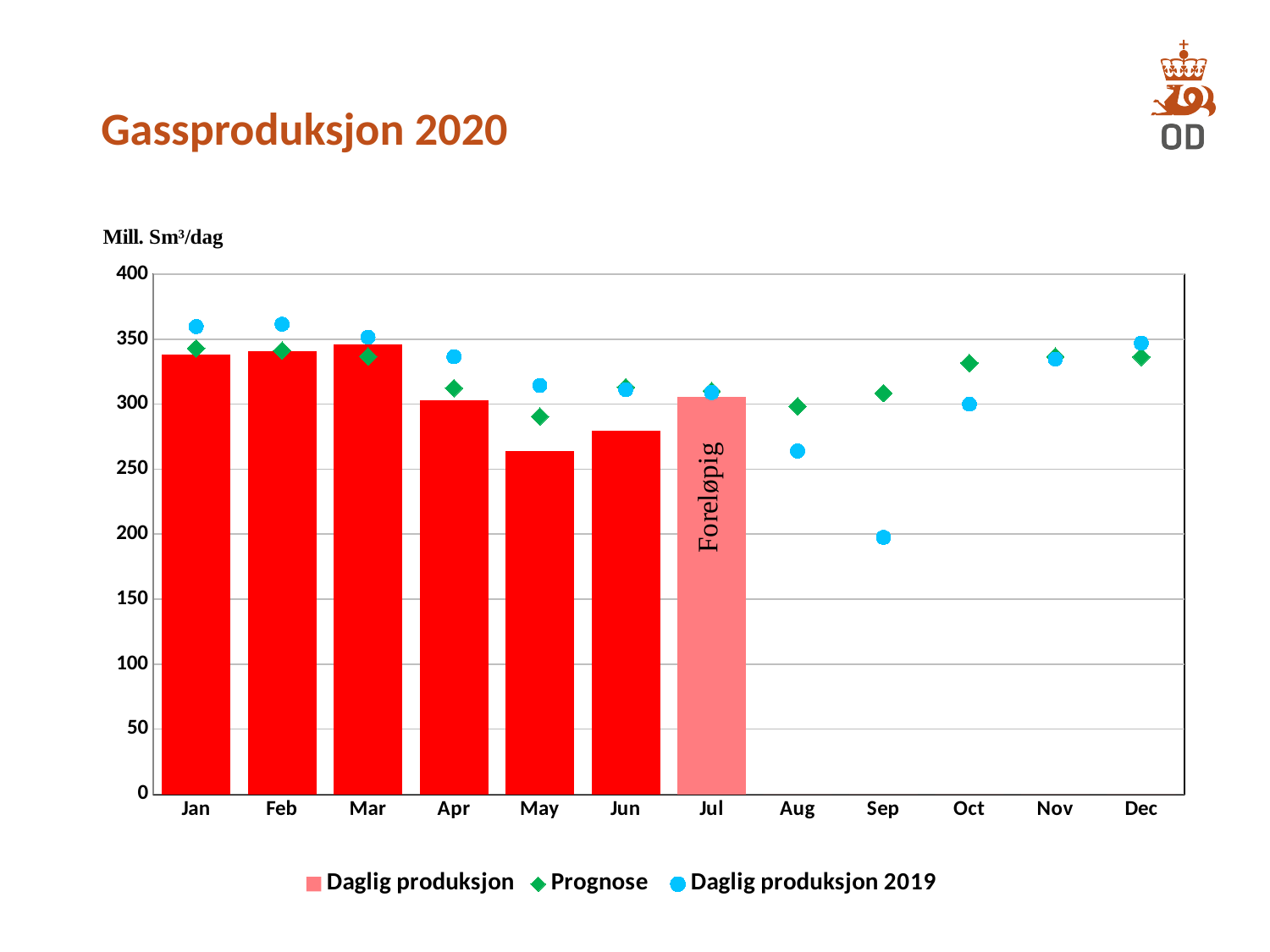
What word is written on the Jul bar? Foreløpig How many series does the legend list? 3 Is the Daglig produksjon value for May greater or less than 300? less In Sep, which is larger: the Prognose value or the Daglig produksjon 2019 value? Prognose Which month has the lowest Daglig produksjon bar? May Is the Prognose value for Oct greater or less than 300? greater What is the title of the chart? Gassproduksjon 2020 Do the Daglig produksjon bars rise or fall from Jan to May? fall Is the Daglig produksjon 2019 value for Sep greater or less than 250? less What kind of chart is used for the Daglig produksjon series? Bar chart Which month has the lowest Daglig produksjon 2019 value? Sep How many months are shown on the x axis? 12